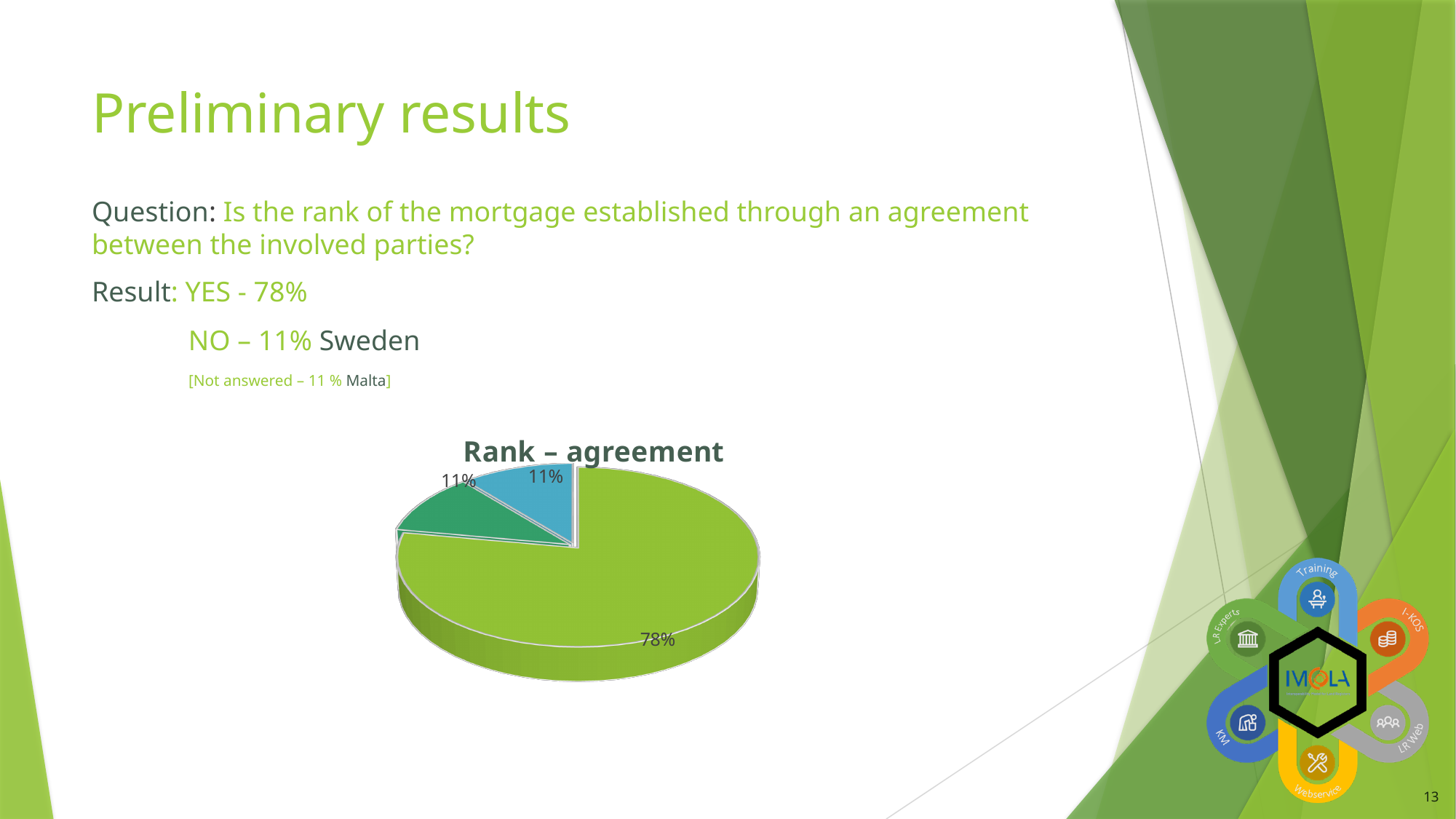
What is the title of the chart? Rank – agreement What is the value of the smallest slice in the pie chart? 11% How many slices does the pie chart have? 3 What share of the pie does the dark green slice represent? 11% What is the difference between the largest slice and the blue slice? 67% What colour is the largest slice of the pie chart? light green What share of the pie does the blue slice represent? 11% What share of the pie does the light green slice represent? 78% What kind of chart is shown on the slide? pie chart Which is larger, the light green slice or the dark green slice? light green slice Is the value of the largest slice greater or less than 50%? greater What is the value of the largest slice in the pie chart? 78%